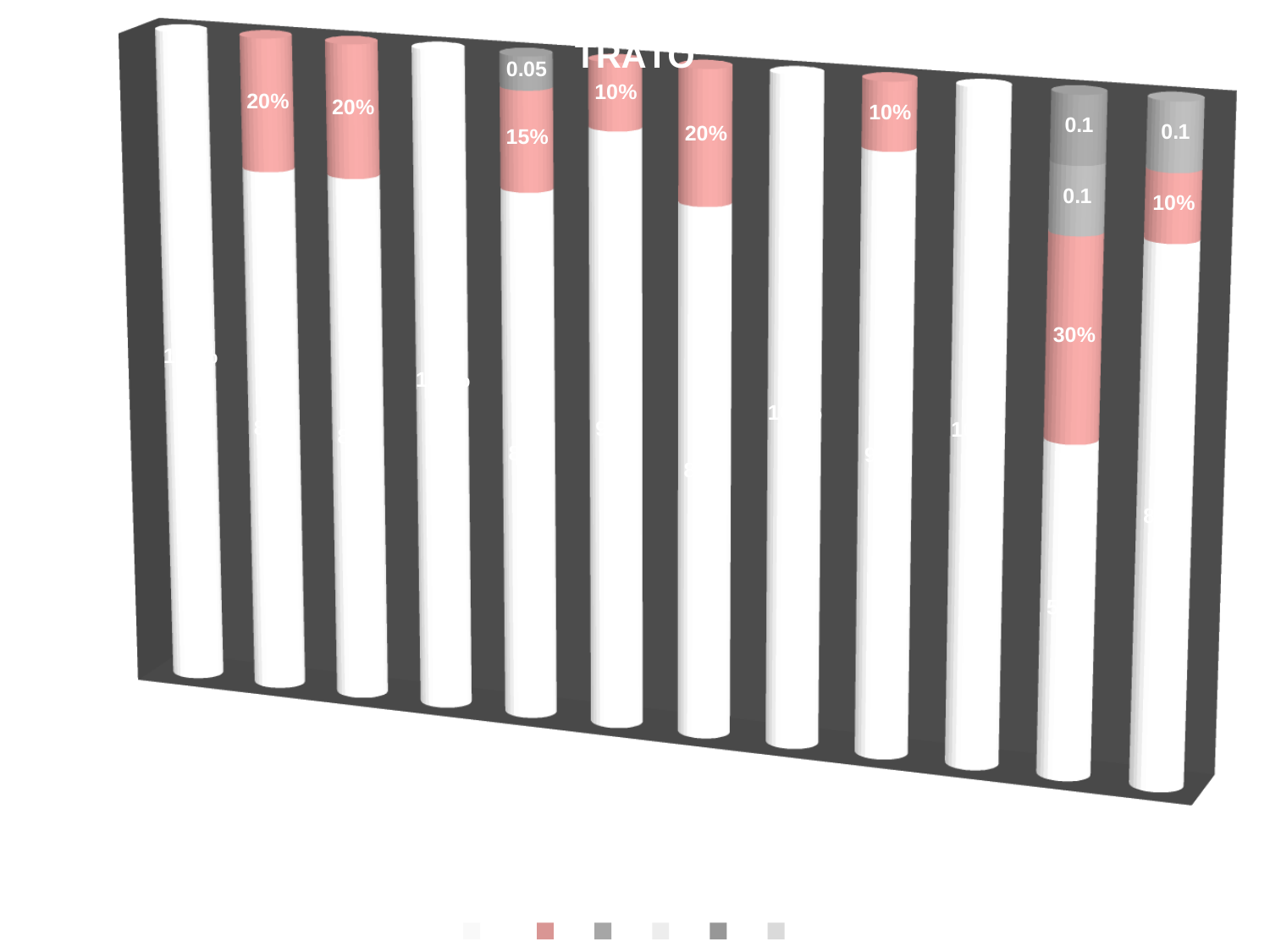
What kind of chart is shown on the slide? Stacked bar chart What is the value printed on the pink segment of the second bar from the left? 20% How many series does the legend list? 6 How many bars include a grey segment? 3 Is the pink segment of the eleventh bar from the left larger or smaller than the pink segment of the rightmost bar? Larger Which bar has the largest labelled pink segment? The eleventh bar from the left (30%) What is the value printed on the pink segment of the eleventh bar from the left? 30% What is the value printed on the pink segment of the rightmost bar? 10% What is the value printed on the pink segment of the fifth bar from the left? 15% How many bars are plotted in the chart? 12 What is the difference between the pink segment of the eleventh bar (30%) and the pink segment of the rightmost bar (10%)? 20% What is the value printed on the grey segment at the top of the fifth bar from the left? 0.05